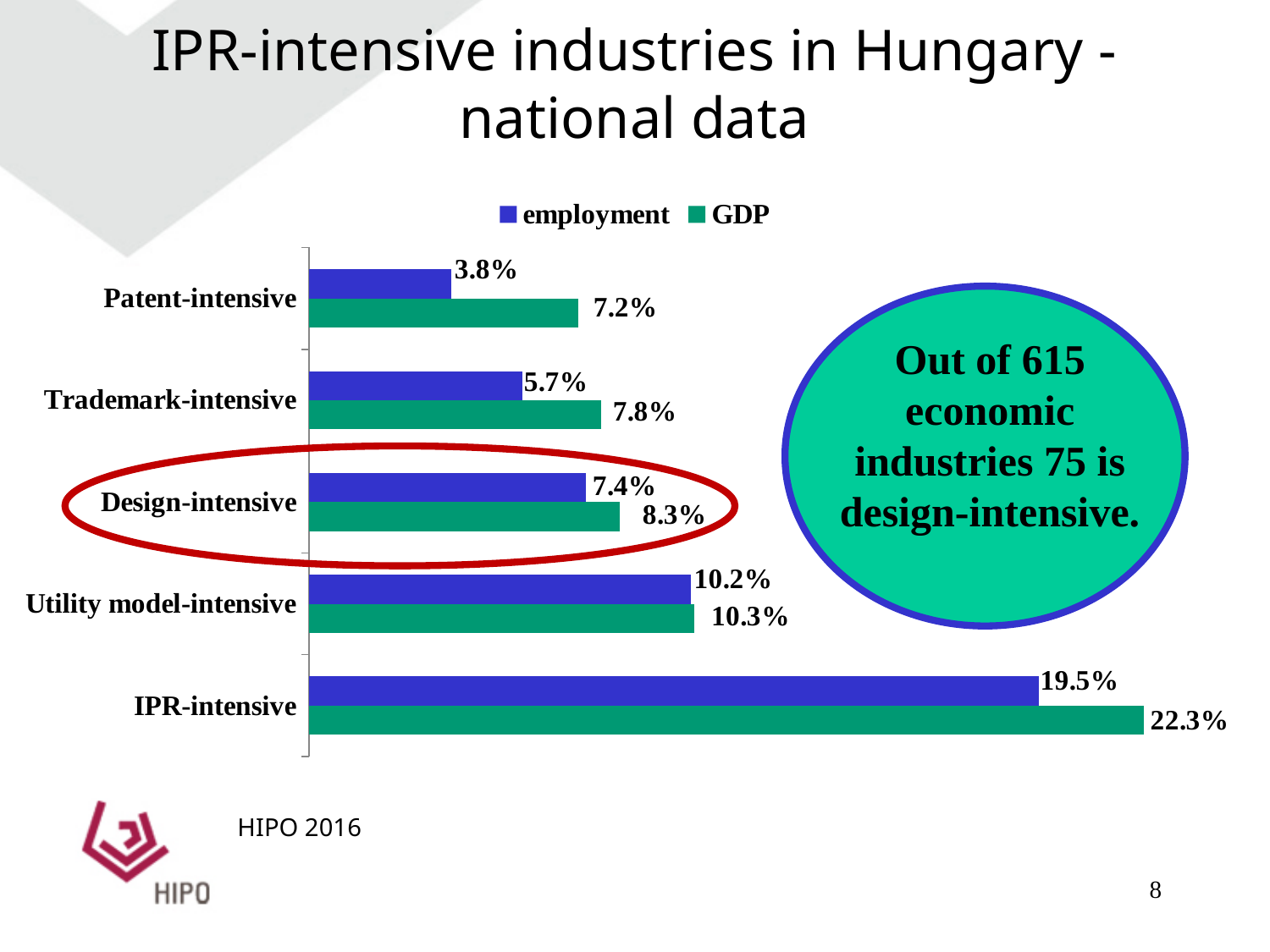
Which is larger for Trademark-intensive industries, the employment value or the GDP value? GDP What is the employment value for Trademark-intensive industries? 5.7% How many categories are shown on the chart? 5 What kind of chart is shown on the slide? Bar chart What is the GDP value for IPR-intensive industries? 22.3% What is the difference between the GDP and employment values for Patent-intensive industries? 3.4% What is the employment value for Design-intensive industries? 7.4% Which category has the lowest employment value? Patent-intensive How many series does the legend list? 2 Which category has the highest GDP value? IPR-intensive What is the GDP value for Patent-intensive industries? 7.2% What is the difference between the GDP value for IPR-intensive and the GDP value for Utility model-intensive industries? 12.0%